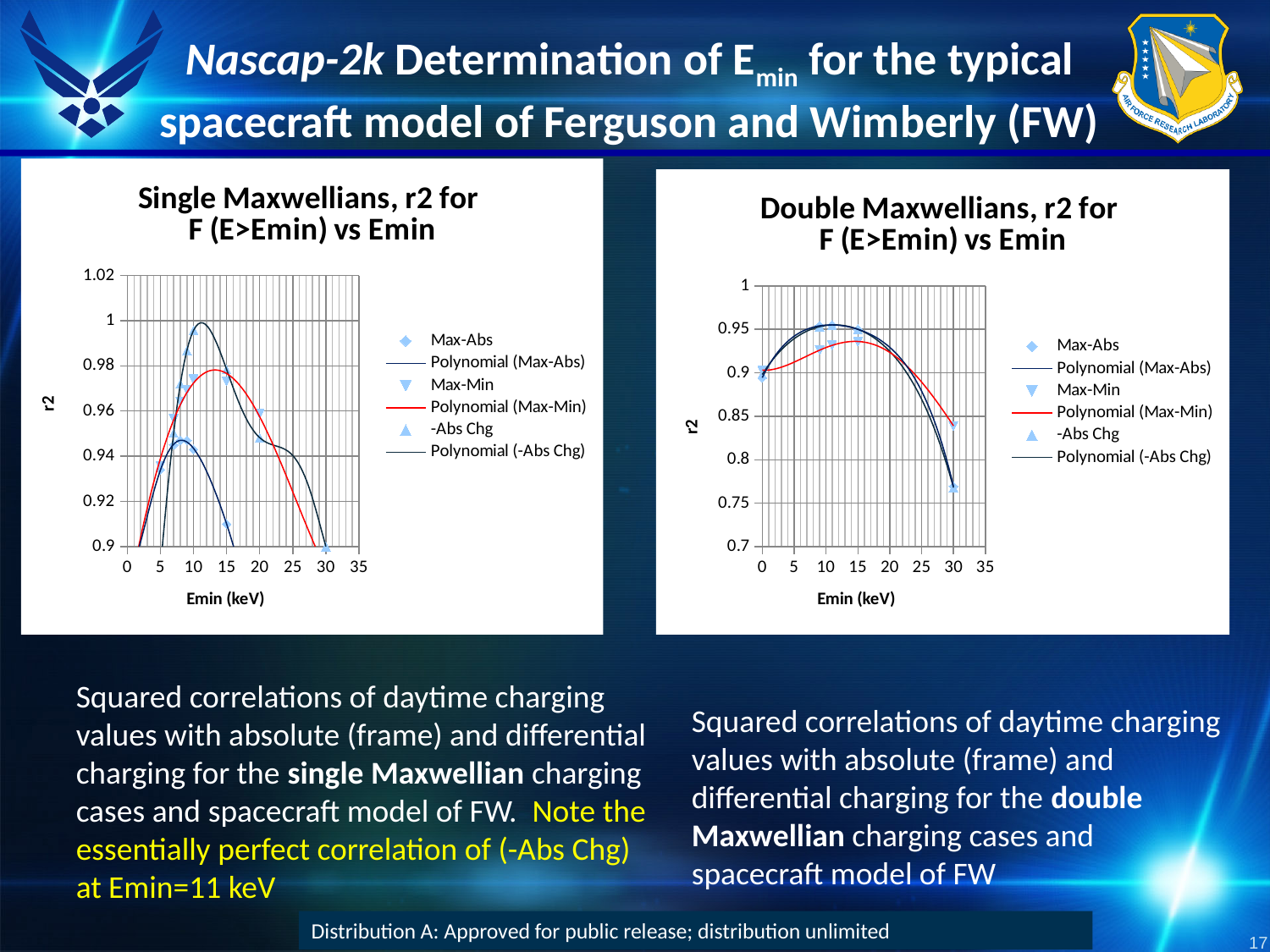
In the 'Single Maxwellians' chart, is the -Abs Chg value near Emin = 11 keV greater or less than 0.98? greater In the 'Single Maxwellians' chart, do the plotted r2 values rise or fall as Emin increases from 20 keV to 30 keV? fall In the 'Double Maxwellians' chart, what is the label of the y axis? r2 How many tick marks are labelled on the x axis of the 'Double Maxwellians' chart? 8 What kind of chart is the 'Single Maxwellians, r2 for F (E>Emin) vs Emin' chart? Scatter chart with polynomial trendlines In the 'Double Maxwellians' chart, do the plotted r2 values rise or fall as Emin increases from 15 keV to 30 keV? fall How many entries does the legend of the 'Double Maxwellians, r2 for F (E>Emin) vs Emin' chart list? 6 In the 'Single Maxwellians' chart, what is the label of the x axis? Emin (keV) In the 'Double Maxwellians' chart, is the highest plotted point greater or less than 0.9? greater In the 'Single Maxwellians' chart, is the lowest plotted point (at Emin = 30 keV) greater or less than 0.92? less What is the maximum value shown on the y axis of the 'Single Maxwellians' chart? 1.02